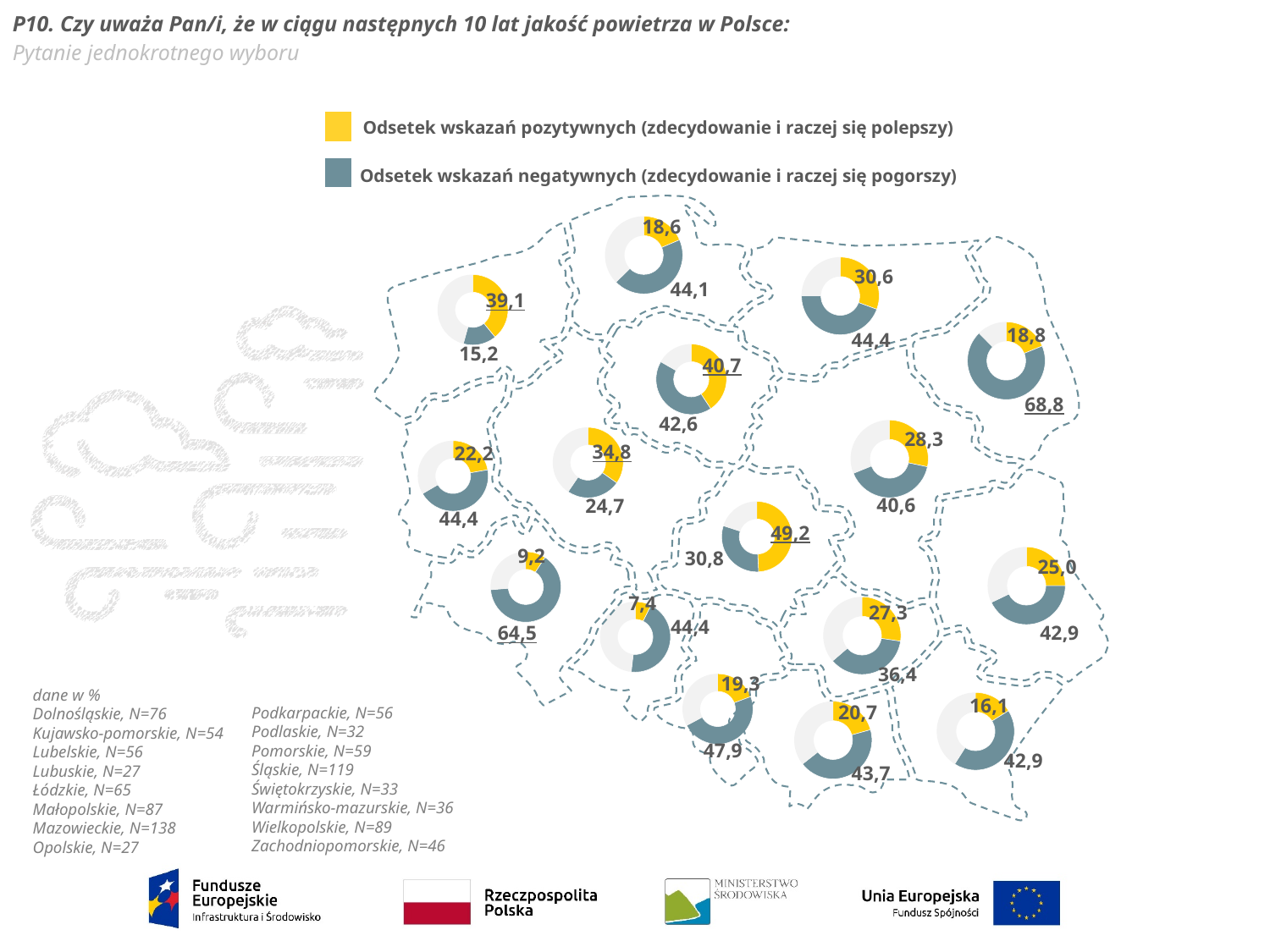
What kind of charts are placed on the map? Donut (pie) charts In the donut chart at the far right of the map (east), where the negative share is 68,8, what is the positive share? 18,8 How many series does the legend list? 2 In the donut chart at the top-left of the map (north-west), what is the difference between the positive share (39,1) and the negative share (15,2)? 23,9 How many donut charts are shown on the map of Poland? 16 Which colour represents the share of positive answers (odsetek wskazań pozytywnych) in the legend? Yellow In the donut chart in the centre of the map, which is larger: the positive share (49,2) or the negative share (30,8)? Positive share (49,2) In the donut chart at the top-left of the map (north-west), what is the share of negative answers? 15,2 Across all the donut charts on the map, what is the highest share of positive answers shown? 49,2 Across all the donut charts on the map, what is the lowest share of positive answers shown? 7,4 In the donut chart at the far right of the map (east), what is the difference between the negative share (68,8) and the positive share (18,8)? 50,0 Across all the donut charts on the map, what is the highest share of negative answers shown? 68,8